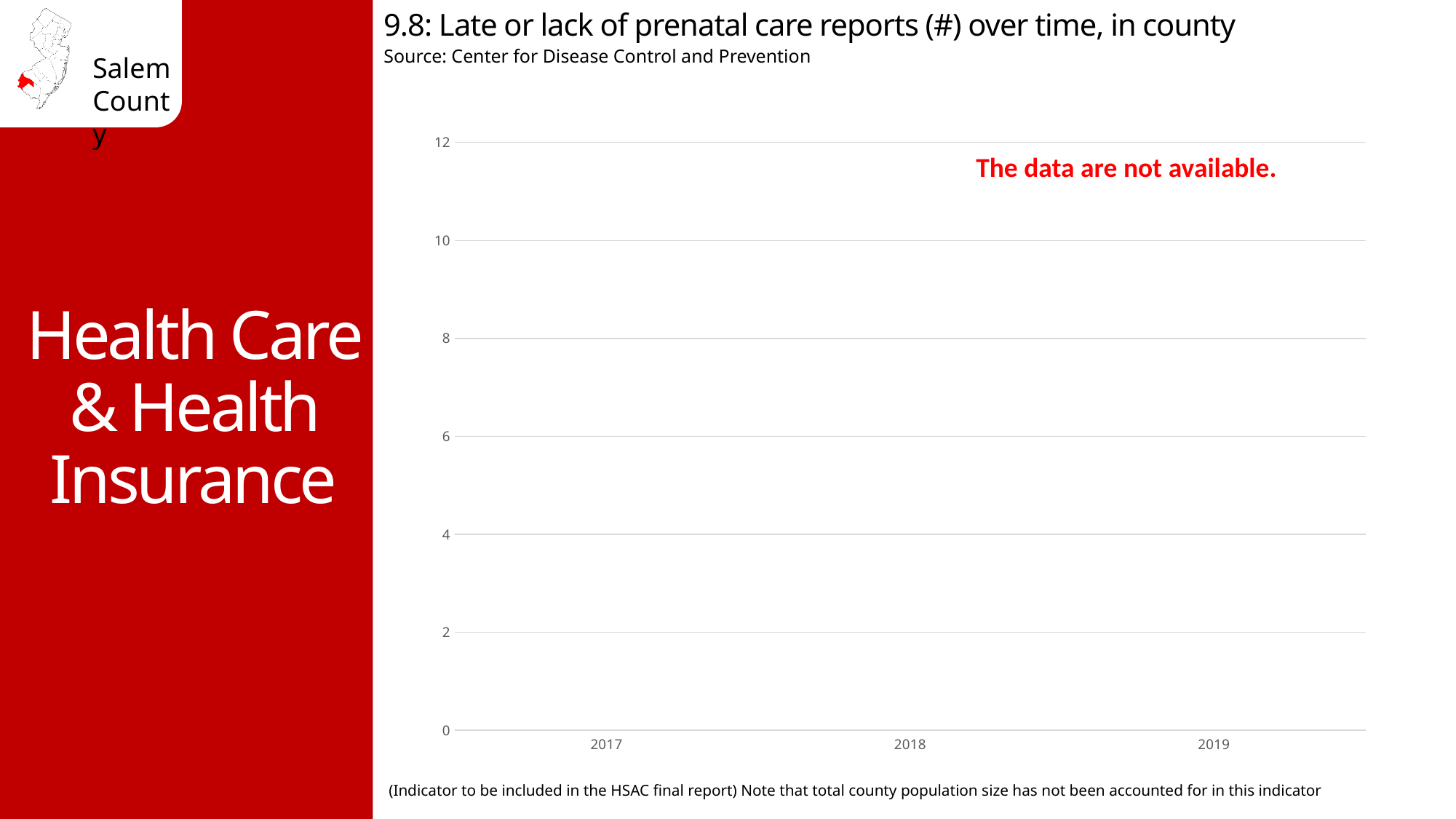
How many years are labelled on the x axis of the chart? 3 What is the highest value labelled on the y axis of the chart? 12 What is the first year shown on the x axis of the chart? 2017 What is the last year shown on the x axis of the chart? 2019 What does the red text on the chart say about the data? The data are not available. What is the source given for the chart? Center for Disease Control and Prevention